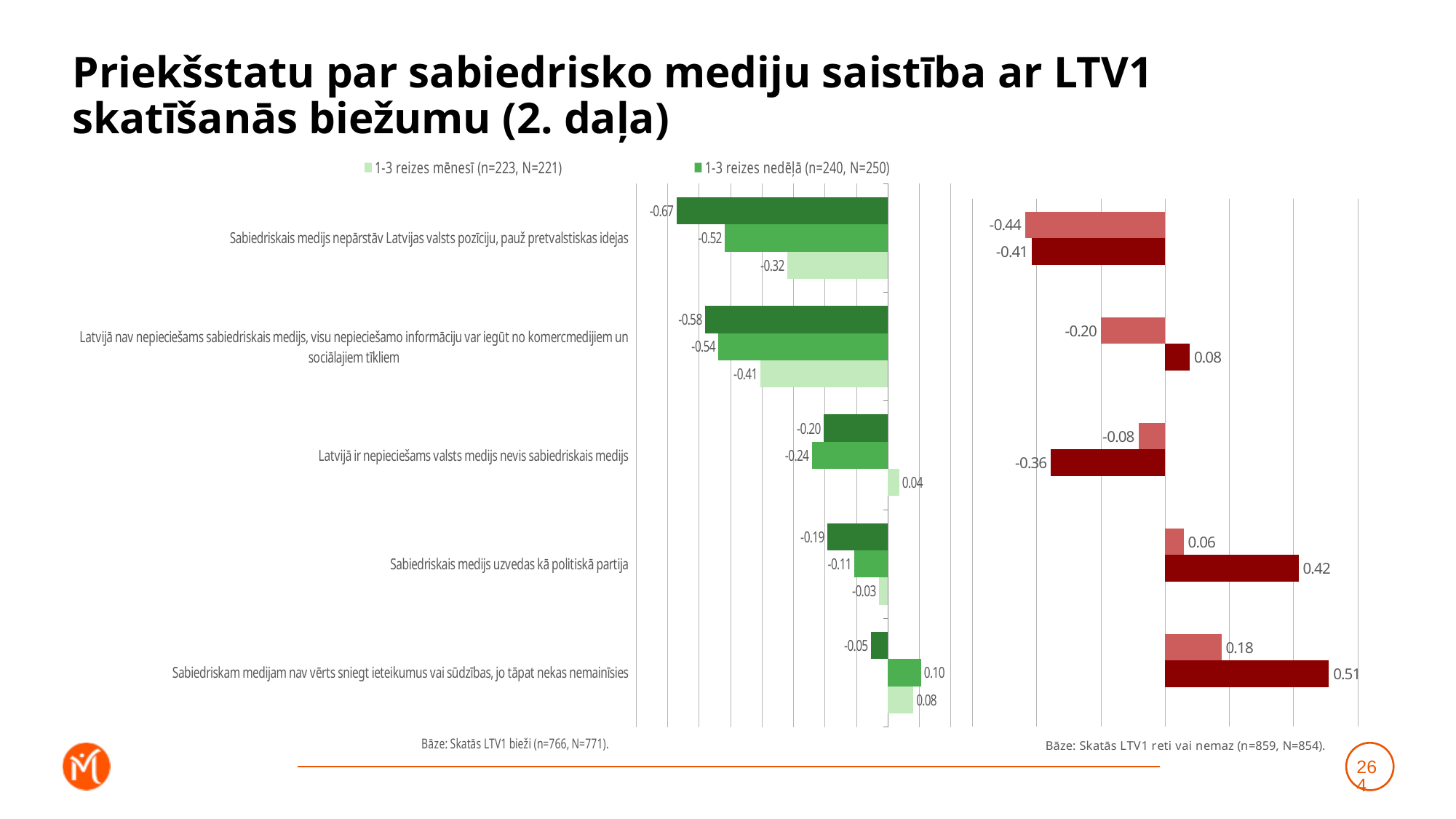
What kind of chart is shown on the left side of the slide? bar chart How many series does the legend above the left-hand chart list? 2 In the right-hand (red) chart, is the dark red bar value for 'Latvijā ir nepieciešams valsts medijs nevis sabiedriskais medijs' larger or smaller than the lighter red bar value for the same statement? smaller In the left-hand chart, what is the difference between the '1-3 reizes nedēļā' value (-0.52) and the '1-3 reizes mēnesī' value (-0.32) for 'Sabiedriskais medijs nepārstāv Latvijas valsts pozīciju, pauž pretvalstiskas idejas'? 0.20 In the left-hand chart, what is the value for '1-3 reizes mēnesī (n=223, N=221)' for 'Sabiedriskam medijam nav vērts sniegt ieteikumus vai sūdzības, jo tāpat nekas nemainīsies'? 0.08 In the left-hand chart, what is the value for '1-3 reizes mēnesī (n=223, N=221)' for 'Latvijā nav nepieciešams sabiedriskais medijs, visu nepieciešamo informāciju var iegūt no komercmedijiem un sociālajiem tīkliem'? -0.41 In the left-hand chart, which statement has the lowest value for '1-3 reizes nedēļā (n=240, N=250)'? Latvijā nav nepieciešams sabiedriskais medijs, visu nepieciešamo informāciju var iegūt no komercmedijiem un sociālajiem tīkliem In the left-hand chart, what is the value for '1-3 reizes nedēļā (n=240, N=250)' for 'Sabiedriskais medijs nepārstāv Latvijas valsts pozīciju, pauž pretvalstiskas idejas'? -0.52 In the right-hand (red) chart, what is the value of the dark red bar for 'Sabiedriskais medijs uzvedas kā politiskā partija'? 0.42 How many statement categories are plotted in the left-hand (green) chart? 5 In the right-hand (red) chart, what is the value of the lighter red bar for 'Latvijā nav nepieciešams sabiedriskais medijs, visu nepieciešamo informāciju var iegūt no komercmedijiem un sociālajiem tīkliem'? -0.20 In the right-hand (red) chart, which statement has the highest dark red bar value? Sabiedriskam medijam nav vērts sniegt ieteikumus vai sūdzības, jo tāpat nekas nemainīsies